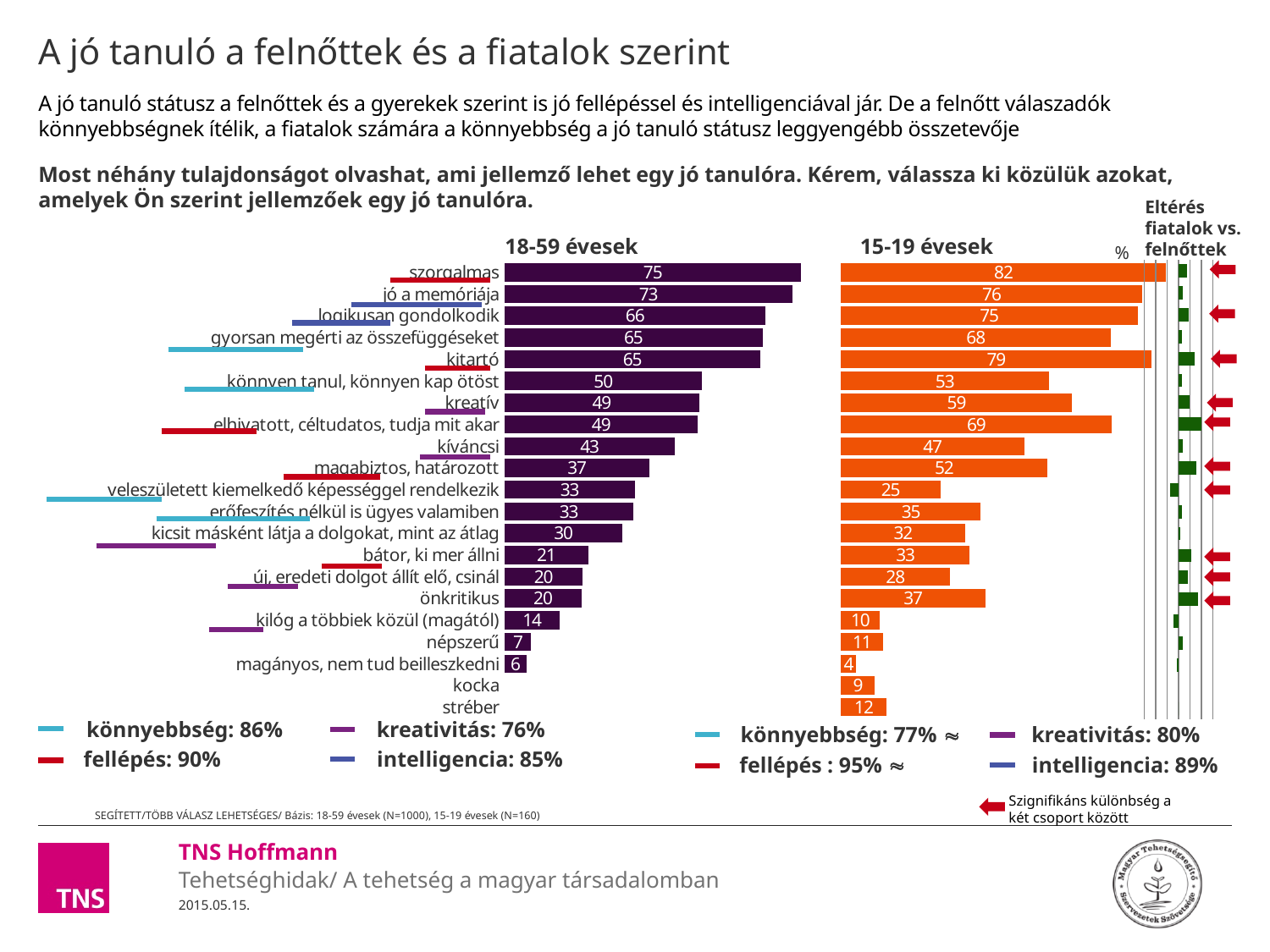
In the 15-19 évesek chart, which category has the highest value? szorgalmas In the 18-59 évesek chart, what is the value for kíváncsi? 43 In the 15-19 évesek chart, which category has the lowest value? magányos, nem tud beilleszkedni What is the difference between the 15-19 évesek and 18-59 évesek values for elhivatott, céltudatos, tudja mit akar? 20 What type of chart is used to show the 18-59 évesek data? Bar chart Which is larger for veleszületett kiemelkedő képességgel rendelkezik: the 18-59 évesek value or the 15-19 évesek value? 18-59 évesek What is the difference between szorgalmas and jó a memóriája in the 18-59 évesek chart? 2 In the 18-59 évesek chart, what is the value for szorgalmas? 75 In the 18-59 évesek chart, which category has the highest value? szorgalmas In the 15-19 évesek chart, what is the value for önkritikus? 37 In the 15-19 évesek chart, what is the value for kitartó? 79 What colour are the bars in the 15-19 évesek chart? Orange